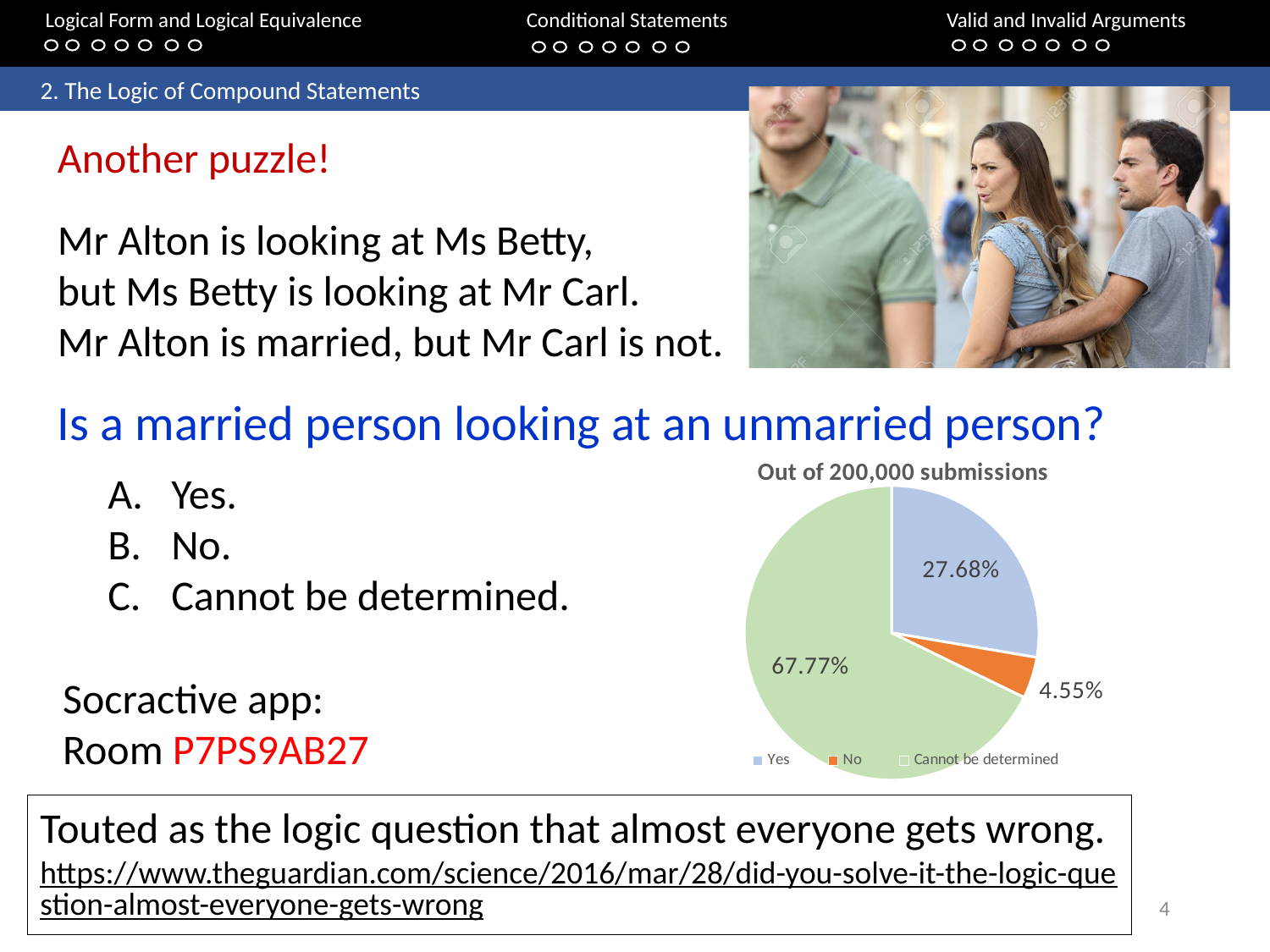
What percentage of submissions answered "No"? 4.55% What percentage of submissions answered "Yes"? 27.68% What percentage of submissions answered "Cannot be determined"? 67.77% What is the title of the pie chart? Out of 200,000 submissions How many entries does the legend of the pie chart list? 3 Which answer received the smallest share of submissions? No What kind of chart is shown on the slide? pie chart Which received a larger share of submissions, "Yes" or "No"? Yes Which answer received the largest share of submissions? Cannot be determined What colour is the "No" slice in the pie chart? orange How many slices does the pie chart have? 3 What is the difference in percentage points between the "Cannot be determined" share and the "Yes" share? 40.09